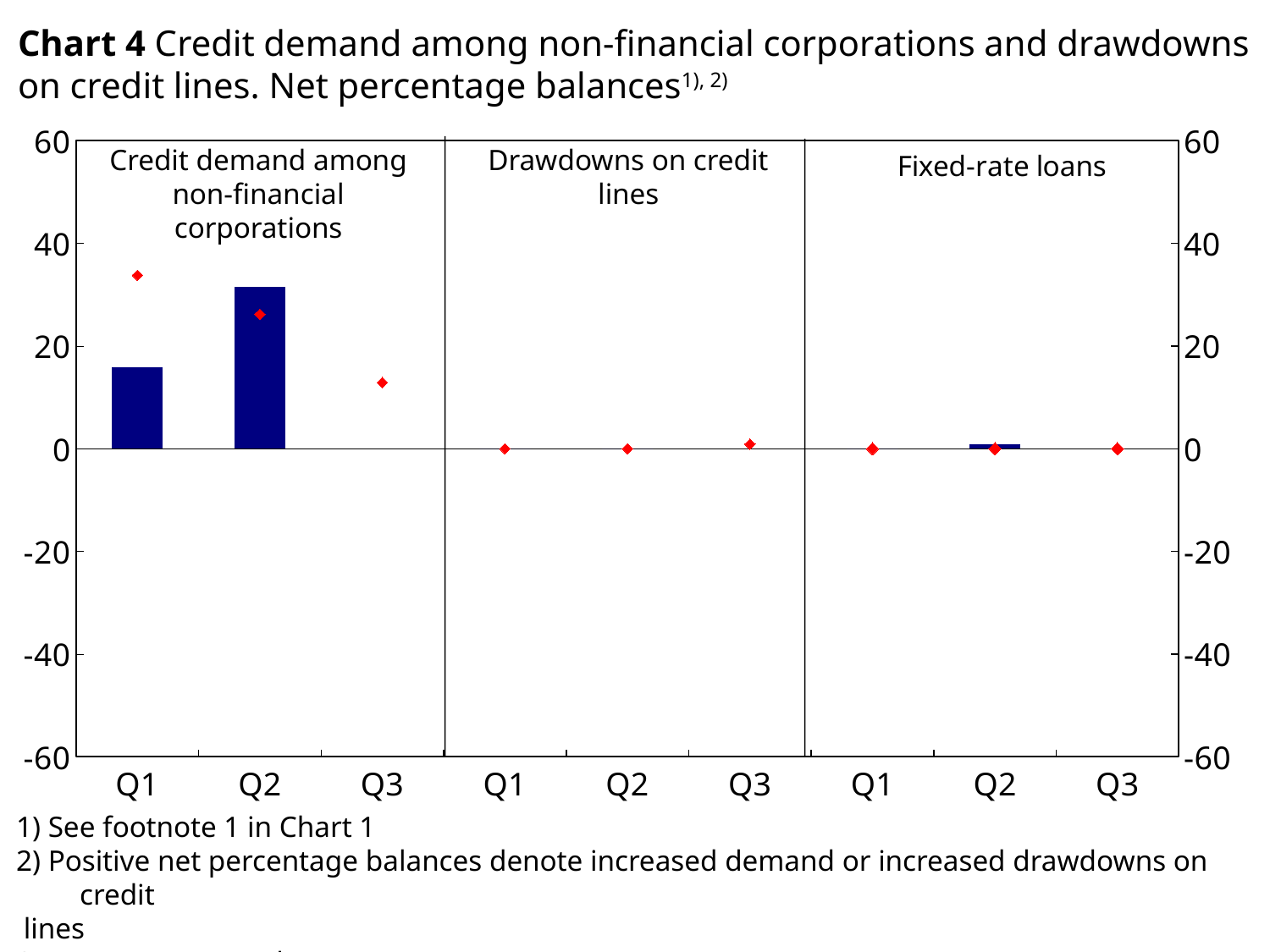
What is the title of the middle panel of the chart? Drawdowns on credit lines How many panels does the chart have? 3 In the 'Credit demand among non-financial corporations' panel, which quarter has the highest red diamond marker? Q1 In the 'Credit demand among non-financial corporations' panel, do the red diamond markers rise or fall from Q1 to Q3? fall What is the title of the right-hand panel of the chart? Fixed-rate loans In the 'Credit demand among non-financial corporations' panel, is the Q1 bar greater or less than 20? less What is the maximum value shown on the vertical axis of the chart? 60 What kind of chart is shown on the slide? bar chart In the 'Credit demand among non-financial corporations' panel, is the Q2 bar greater or less than 20? greater In the 'Credit demand among non-financial corporations' panel, is the Q1 red diamond marker greater or less than 20? greater In the 'Credit demand among non-financial corporations' panel, which quarter has the taller bar, Q1 or Q2? Q2